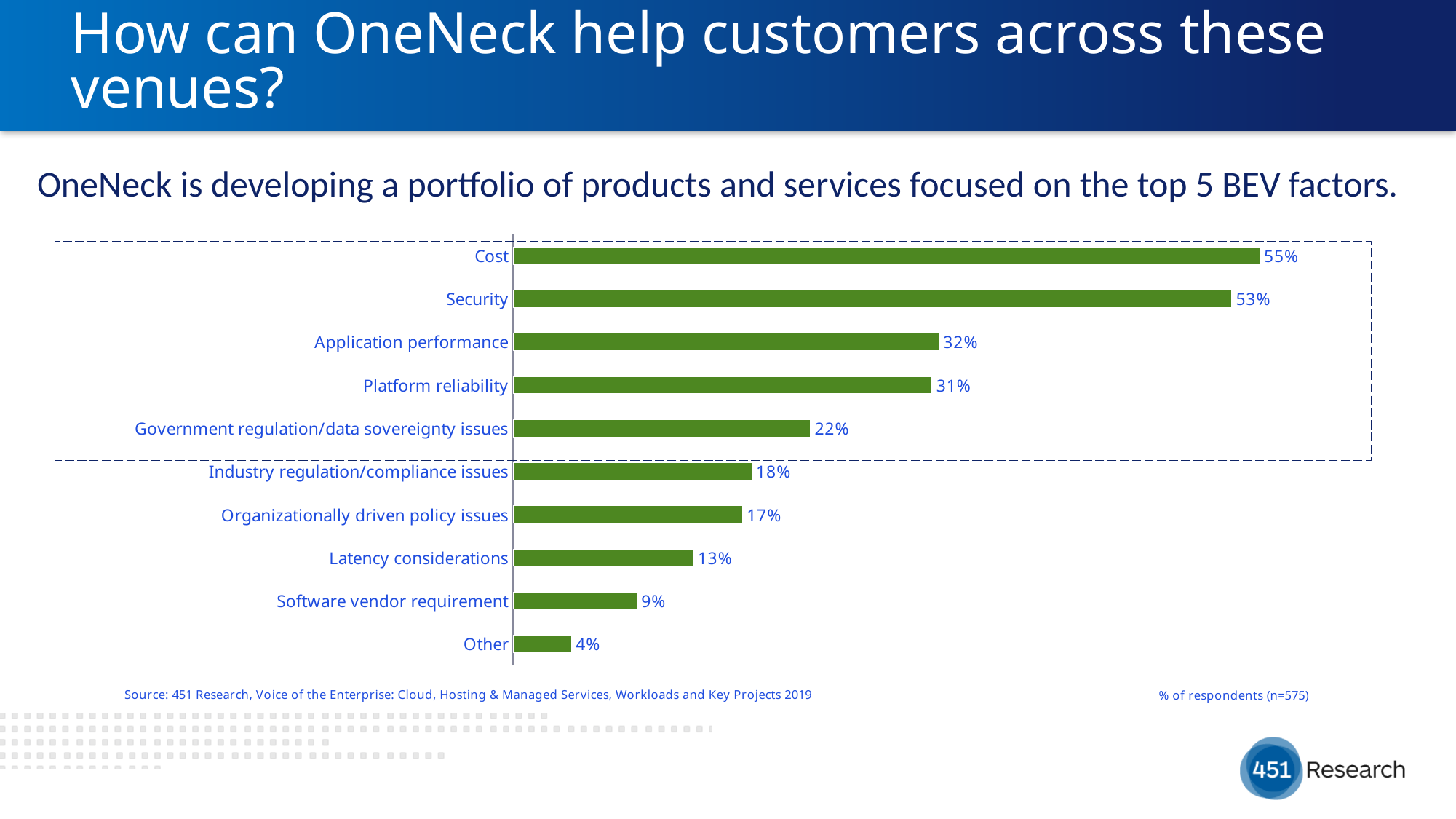
What kind of chart is shown on the slide? Bar chart Which category has the highest value? Cost How many categories are enclosed by the dashed box in the chart? 5 What is the difference between the values for Cost and Security? 2% What is the difference between the values for Application performance and Software vendor requirement? 23% Which category has the lowest value? Other What colour are the bars in the chart? Green Which is larger, the value for Industry regulation/compliance issues or the value for Organizationally driven policy issues? Industry regulation/compliance issues What is the value for Cost? 55% What is the value for Latency considerations? 13% What is the value for Government regulation/data sovereignty issues? 22% How many categories are shown in the chart? 10